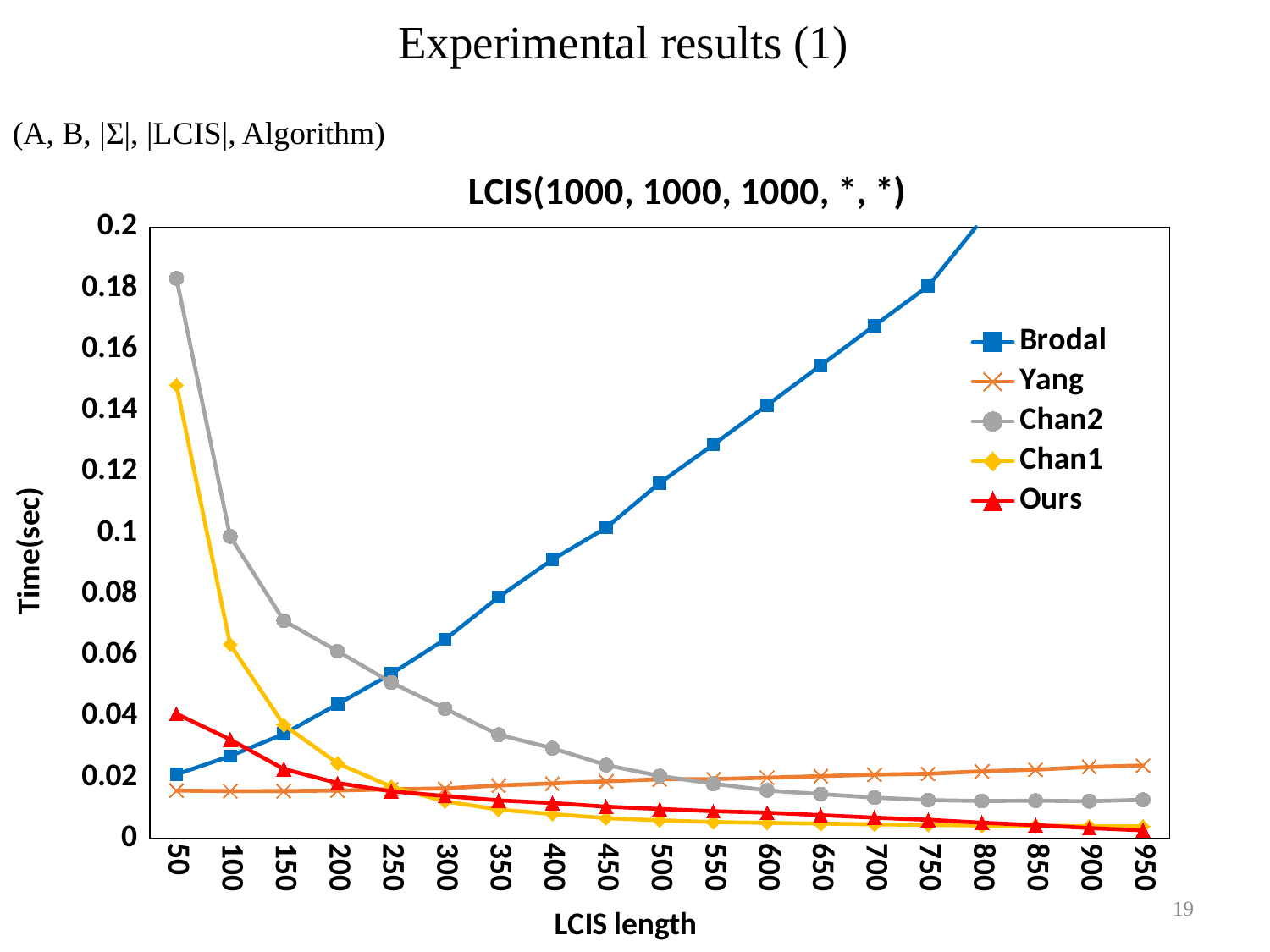
How many series does the legend list? 5 Does the Chan2 series rise or fall as LCIS length increases? fall What kind of chart is shown on the slide? line chart Is the value for Chan2 at LCIS length 50 greater or less than 0.16? greater Which series has the lowest value at LCIS length 950? Ours What is the title of the chart? LCIS(1000, 1000, 1000, *, *) Is the value for Brodal at LCIS length 750 greater or less than 0.16? greater How many LCIS length values are shown on the x axis? 19 Does the Brodal series rise or fall as LCIS length increases? rise Is the value for Yang at LCIS length 950 greater or less than 0.04? less At LCIS length 100, which is larger: Brodal or Chan2? Chan2 Which series has the highest value at LCIS length 50? Chan2